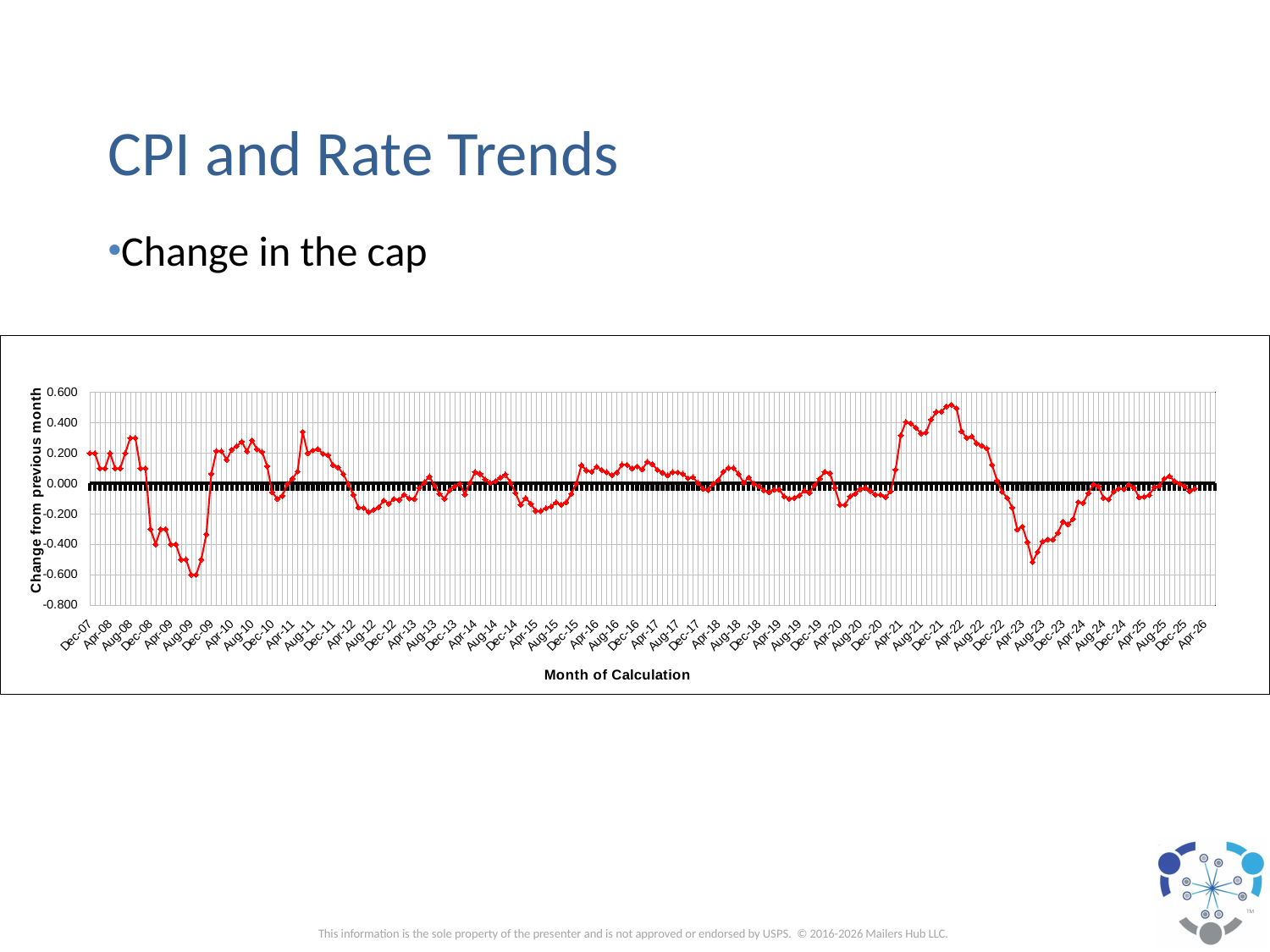
Between Apr-22 and Aug-23, does the line rise or fall? fall What is the title of the horizontal axis of the chart? Month of Calculation What kind of chart is shown on the slide? Line chart Is the lowest point of the line, around Aug-09, greater or less than -0.400? less Is the highest point on the chart in 2009 or in early 2022? early 2022 Is the trough of the line around Aug-23 greater or less than -0.400? less Around which month does the line reach its lowest value? Aug-09 Is the value around Apr-15 greater or less than 0.000? less Between Dec-20 and Dec-21, does the line rise or fall? rise What is the title of the vertical axis of the chart? Change from previous month